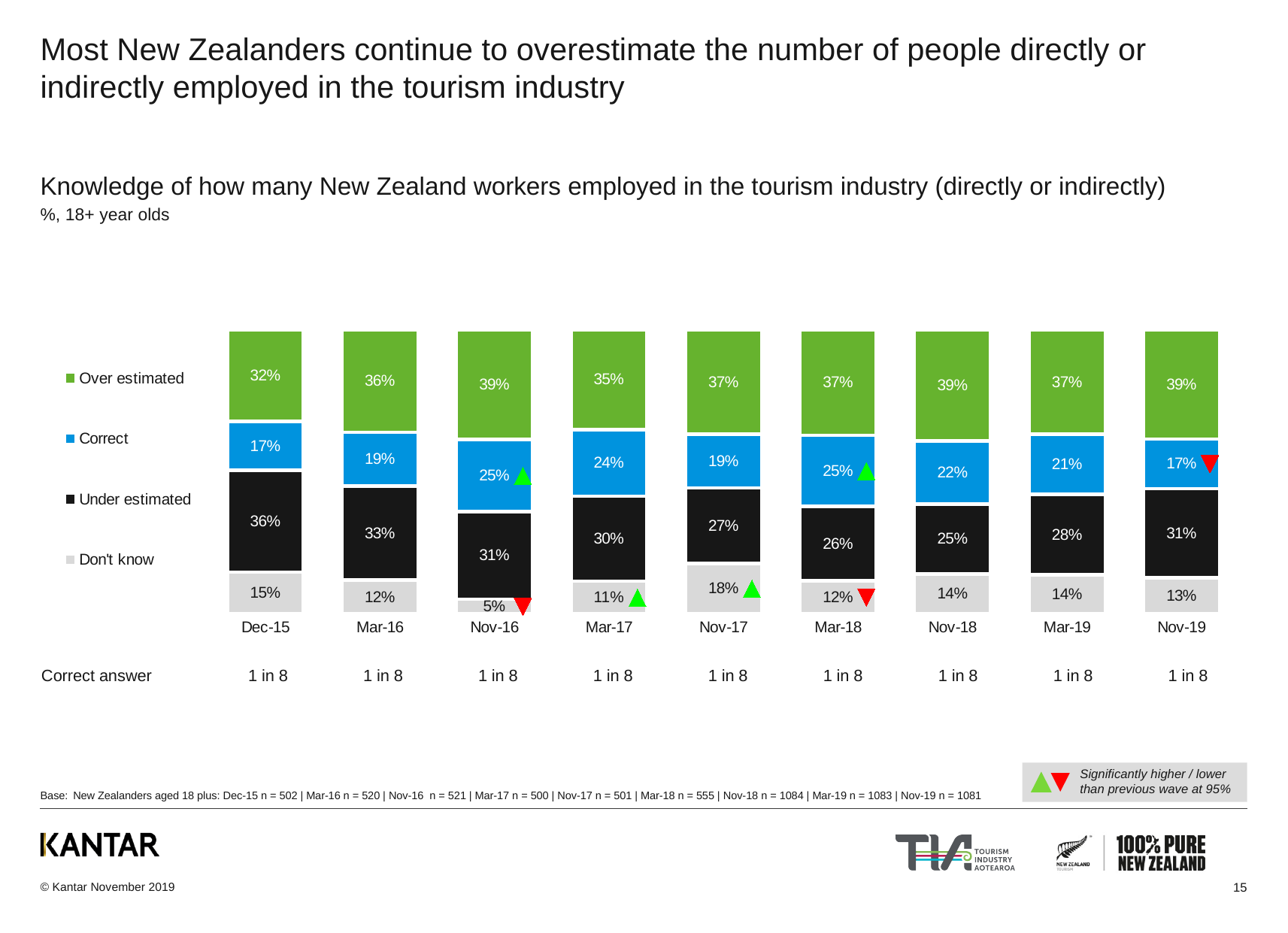
What percentage of respondents over estimated the number of tourism workers in Nov-19? 39% In which wave was the 'Don't know' share lowest? Nov-16 What kind of chart is shown on the slide? Stacked bar chart How many survey waves are shown on the x axis? 9 What percentage of respondents gave the correct answer in Mar-18? 25% What is the correct answer shown beneath each wave? 1 in 8 What is the difference between the 'Correct' share in Mar-17 and in Nov-19? 7 percentage points In which wave was the 'Don't know' share highest? Nov-17 What is the total of the Dec-15 stacked bar? 100% How many series does the legend list? 4 What percentage of respondents under estimated in Dec-15? 36% Which is larger: the 'Under estimated' share in Mar-16 or in Nov-18? Mar-16